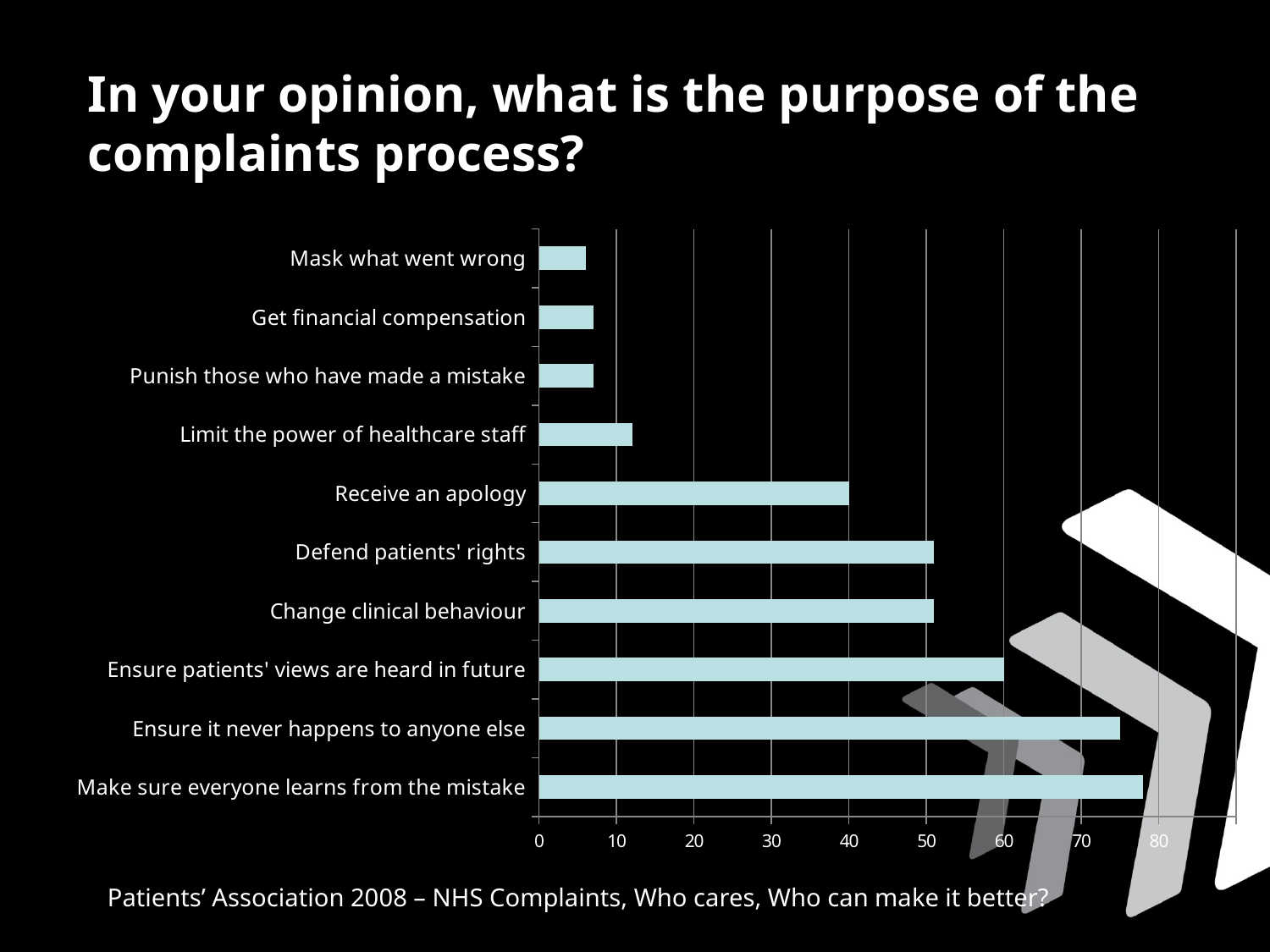
What is the title of the slide containing the chart? In your opinion, what is the purpose of the complaints process? Which category has the highest value in the chart? Make sure everyone learns from the mistake What is the highest value shown on the chart's horizontal axis? 80 What kind of chart is shown on the slide? bar chart Is the value for 'Mask what went wrong' greater or less than 10? less Is the value for 'Limit the power of healthcare staff' greater or less than 20? less Is the value for 'Receive an apology' greater or less than 30? greater Which is larger: the value for 'Limit the power of healthcare staff' or the value for 'Mask what went wrong'? Limit the power of healthcare staff How many categories (purposes) are plotted in the chart? 10 Which is larger: the value for 'Receive an apology' or the value for 'Defend patients' rights'? Defend patients' rights